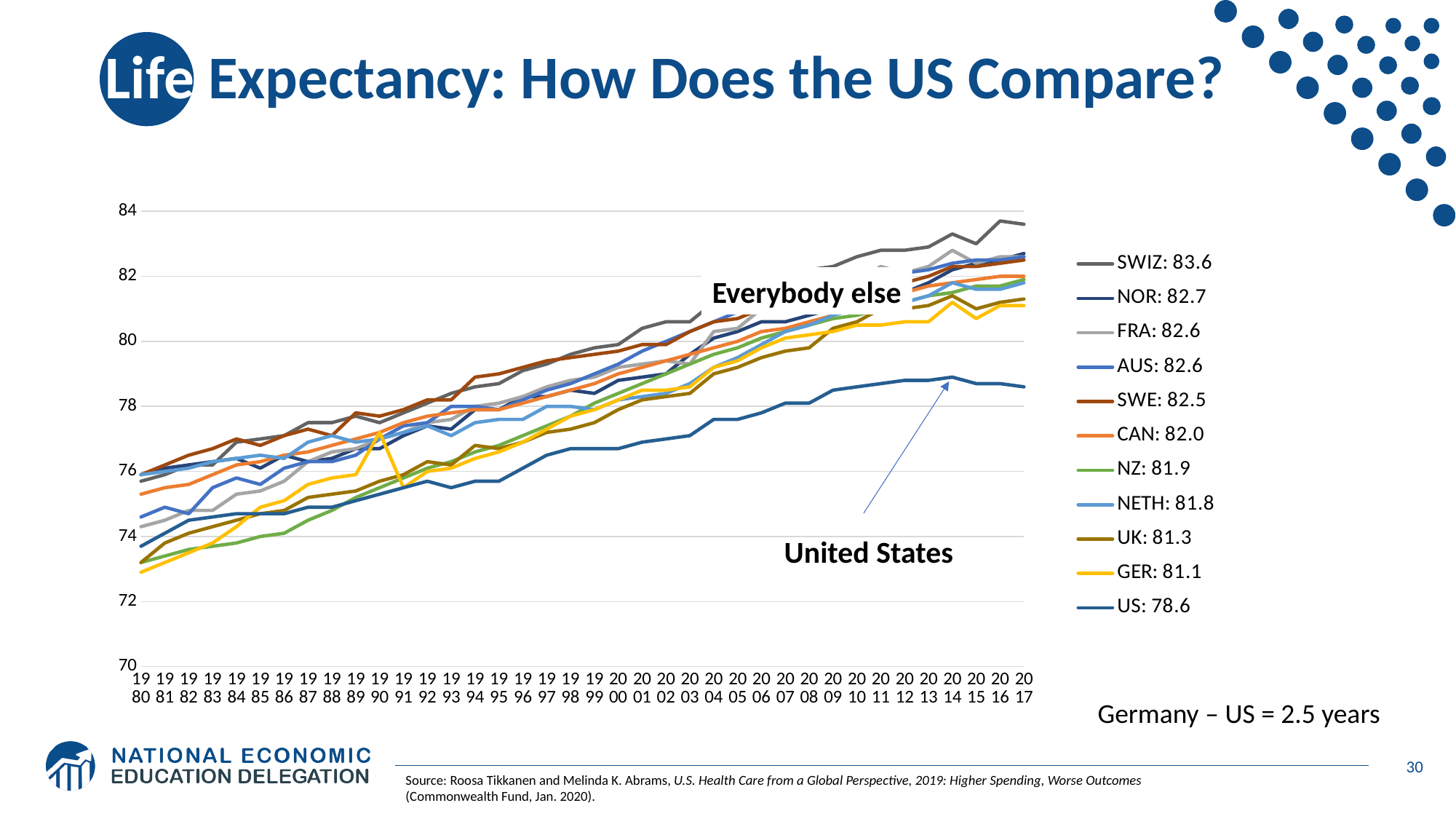
What is the difference between the SWIZ value and the US value shown in the legend? 5.0 Do the life expectancy lines generally rise or fall from 1980 to 2017? rise Which has a higher legend value, NOR or SWE? NOR According to the legend, what is the life expectancy value for the US? 78.6 How many countries (series) does the legend list? 11 According to the legend, what is the life expectancy value for SWIZ? 83.6 By how many years does Germany's life expectancy exceed that of the US, according to the slide? 2.5 years According to the legend, what is the life expectancy value for CAN? 82.0 Which country has the highest life expectancy value in the legend? SWIZ Is the US value in 1990 greater or less than 74? greater What type of chart is shown on the slide? line chart Which country has the lowest life expectancy value in the legend? US